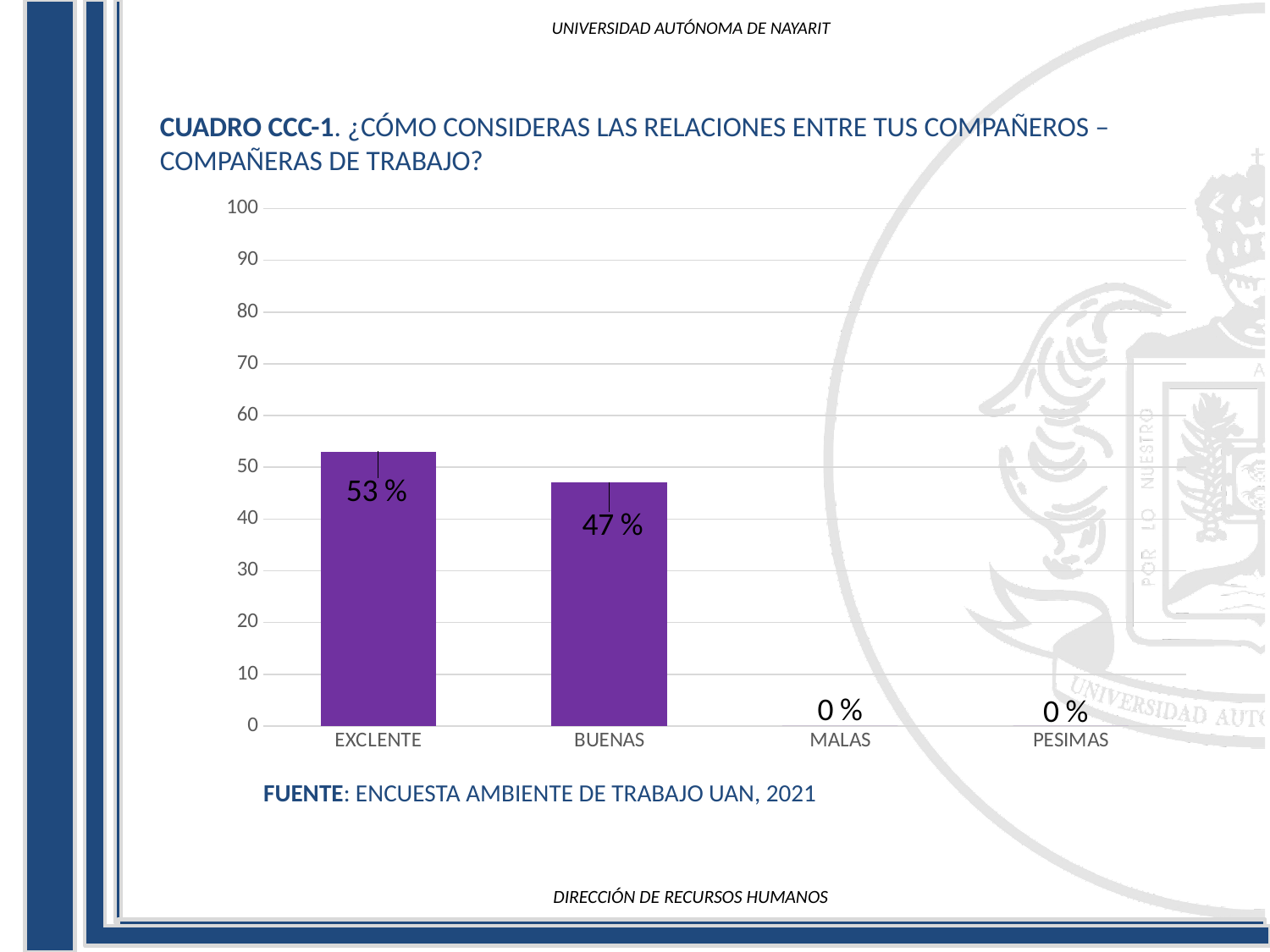
Is the value for BUENAS greater or less than 50? less What source is cited below the chart? ENCUESTA AMBIENTE DE TRABAJO UAN, 2021 Which category has the highest value? EXCLENTE Do the values rise or fall from left to right along the x axis? fall What is the value for EXCLENTE? 53 % What is the difference between the values for EXCLENTE and BUENAS? 6 % How many categories are shown on the x axis? 4 What is the value for BUENAS? 47 % What kind of chart is shown on the slide? bar chart Which is larger, the value for EXCLENTE or the value for BUENAS? EXCLENTE What is the value for PESIMAS? 0 % What is the value for MALAS? 0 %